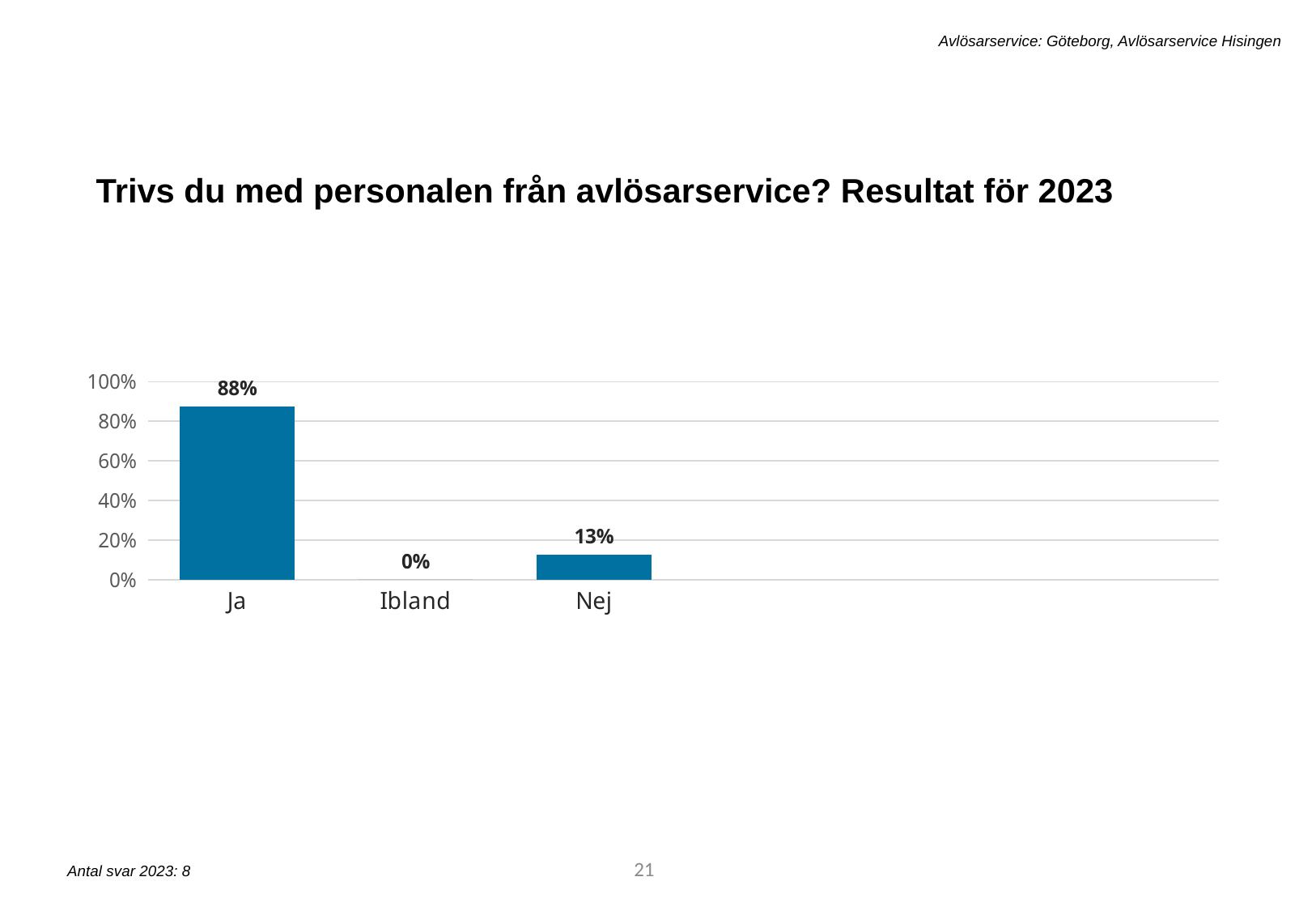
What is the value for Ja? 88% Is the value for Nej greater or less than 20%? less Which category has the lowest value? Ibland Is the value for Ja greater or less than 80%? greater What is the difference between the values for Ja and Nej? 75% What kind of chart is shown on the slide? bar chart What is the value for Nej? 13% How many categories are shown on the x axis? 3 What is the value for Ibland? 0% Which is larger, the value for Nej or the value for Ibland? Nej What is the title of the chart? Trivs du med personalen från avlösarservice? Resultat för 2023 Which category has the highest value? Ja